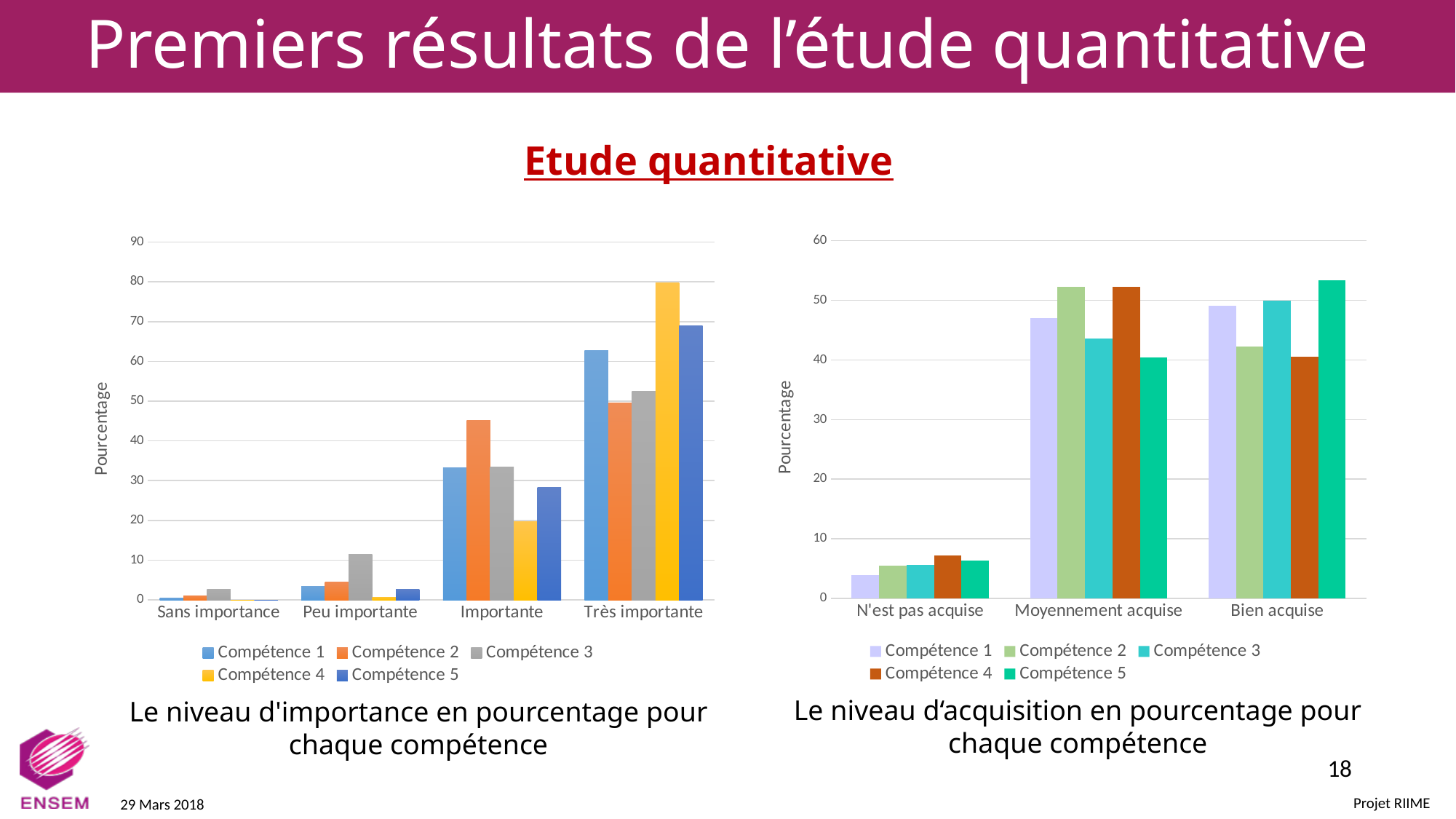
On the left chart (Le niveau d'importance), in which category does Compétence 4 reach its highest value? Très importante On the left chart (Le niveau d'importance), how many categories are shown on the x axis? 4 On the right chart (Le niveau d'acquisition), how many series does the legend list? 5 On the left chart (Le niveau d'importance en pourcentage pour chaque compétence), what kind of chart is shown? bar chart On the left chart (Le niveau d'importance), is the value for Compétence 4 in the Très importante category greater or less than 70? greater On the right chart (Le niveau d'acquisition), is the value for Compétence 4 in the Moyennement acquise category greater or less than 50? greater On the left chart (Le niveau d'importance), in the Très importante category, which is larger: Compétence 1 or Compétence 2? Compétence 1 On the right chart (Le niveau d'acquisition en pourcentage pour chaque compétence), how many categories are shown on the x axis? 3 On the left chart (Le niveau d'importance), how many series does the legend list? 5 On the left chart (Le niveau d'importance), is the value for Compétence 2 in the Importante category greater or less than 40? greater On the right chart (Le niveau d'acquisition), what is the label of the vertical axis? Pourcentage On the right chart (Le niveau d'acquisition), which series has the highest value in the Bien acquise category? Compétence 5